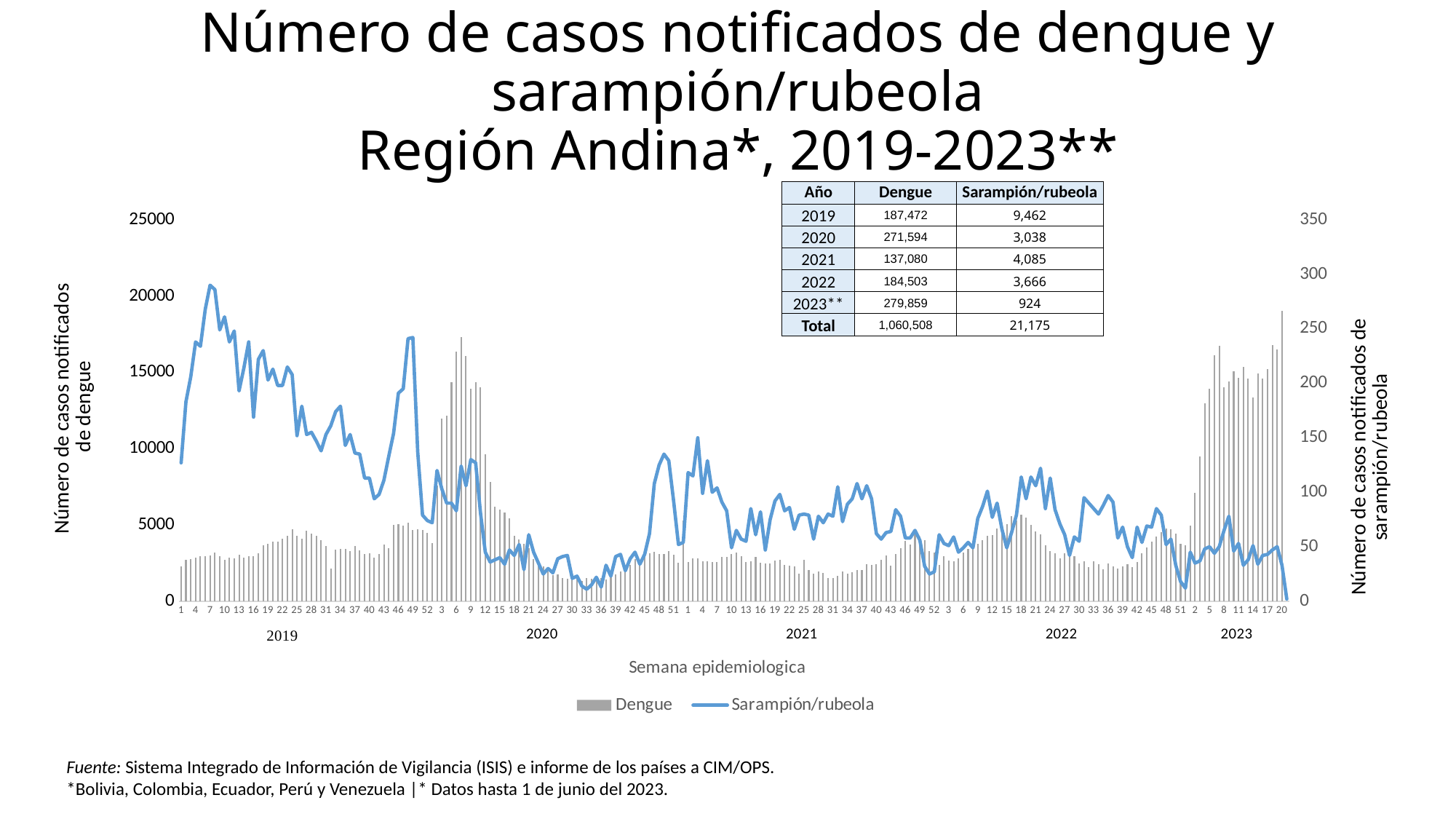
According to the table, how many dengue cases were notified in 2020? 271,594 What is the title of the x axis? Semana epidemiologica How many series does the chart legend list? 2 According to the table, which year had more dengue cases, 2019 or 2022? 2019 Is the dengue bar for week 20 of 2023 greater or less than 15000? greater What kind of chart is shown on the slide? Combined bar and line chart According to the table, how many sarampión/rubeola cases were notified in 2019? 9,462 Is the peak of the sarampión/rubeola line in early 2019 (around week 7) greater or less than 250? greater According to the table, what is the total number of dengue cases for 2019-2023? 1,060,508 According to the table, which year has the highest number of dengue cases? 2023** According to the table, what is the difference between dengue cases in 2020 and 2021? 134,514 According to the table, which year has the lowest number of sarampión/rubeola cases? 2023**